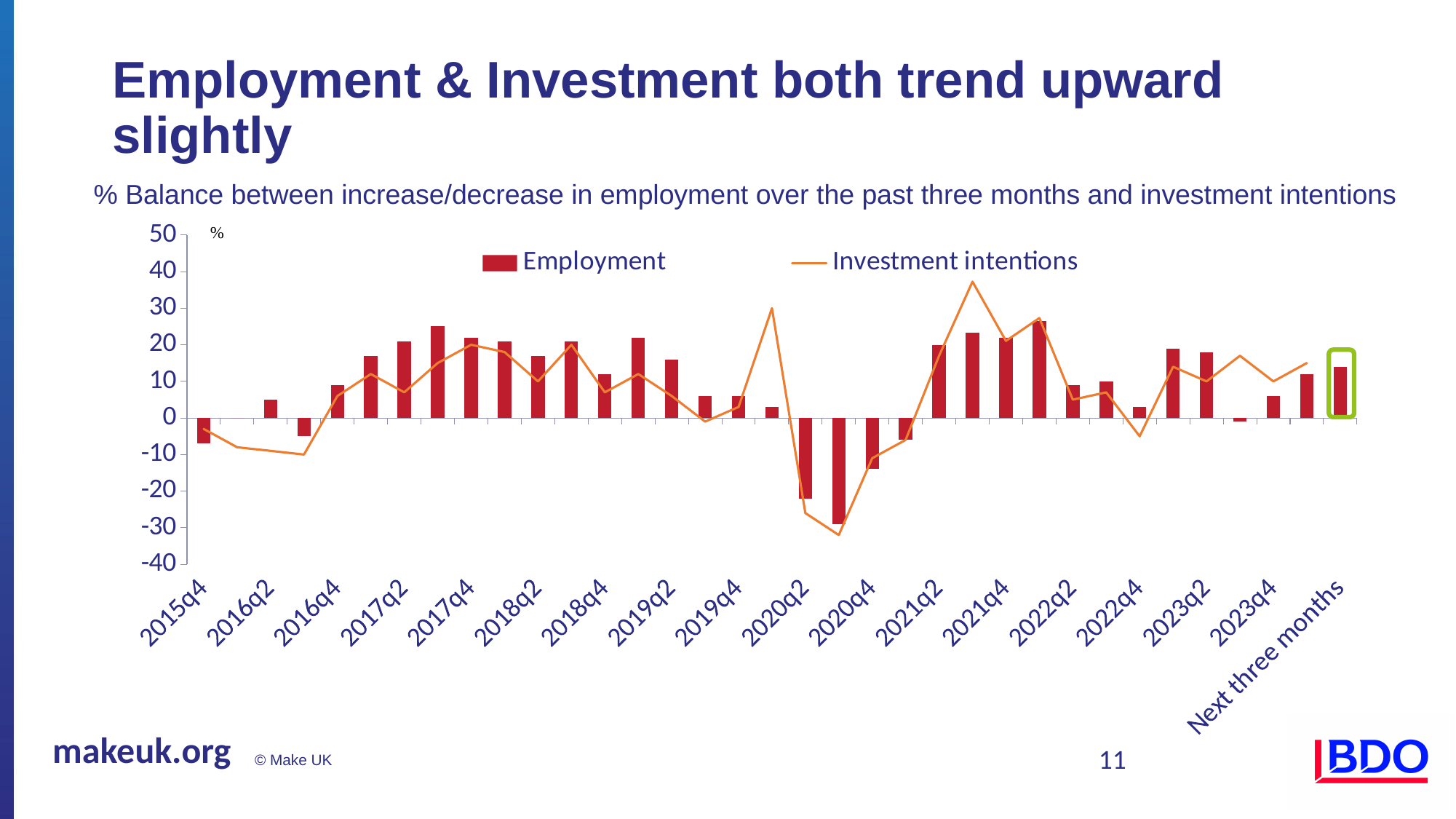
Is the Investment intentions value for 2016q2 greater or less than 0? less How many series does the chart legend list? 2 What kind of chart is used to show the Employment series? bar chart How many category labels are shown on the x axis? 18 Which has the larger Employment value, 2020q2 or 2020q4? 2020q4 Is the Employment value for 2017q2 greater or less than 10? greater What kind of chart is used to show the Investment intentions series? line chart Does the Employment series rise or fall from 2020q2 to 2021q4? rise Is the Investment intentions value for 2020q2 greater or less than -20? less Which has the larger Employment value, 2016q2 or 2017q2? 2017q2 Which x-axis category is highlighted with a green box? Next three months